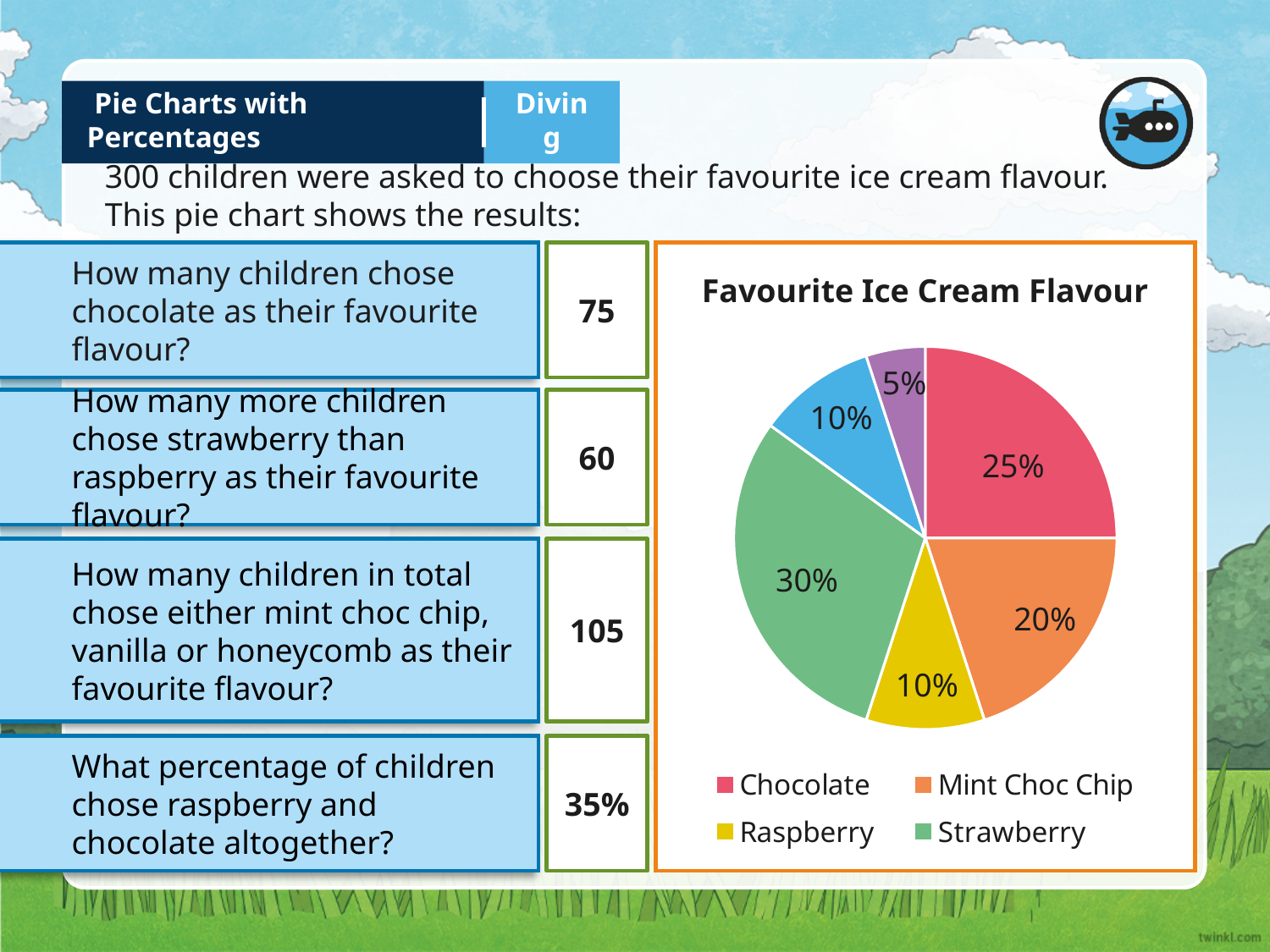
Which slice is larger, Chocolate or Mint Choc Chip? Chocolate What is the title of the chart? Favourite Ice Cream Flavour How many percentage points larger is the Strawberry slice than the Raspberry slice? 20% What percentage of the pie chart is Strawberry? 30% What percentage of the pie chart is Chocolate? 25% Which flavour has the largest slice of the pie chart? Strawberry What kind of chart is shown on the slide? Pie chart How many entries does the legend of the pie chart list? 4 What percentage of the pie chart is Mint Choc Chip? 20% What is the smallest percentage labelled on the pie chart? 5% What percentage of the pie chart is Raspberry? 10% How many slices does the pie chart have? 6